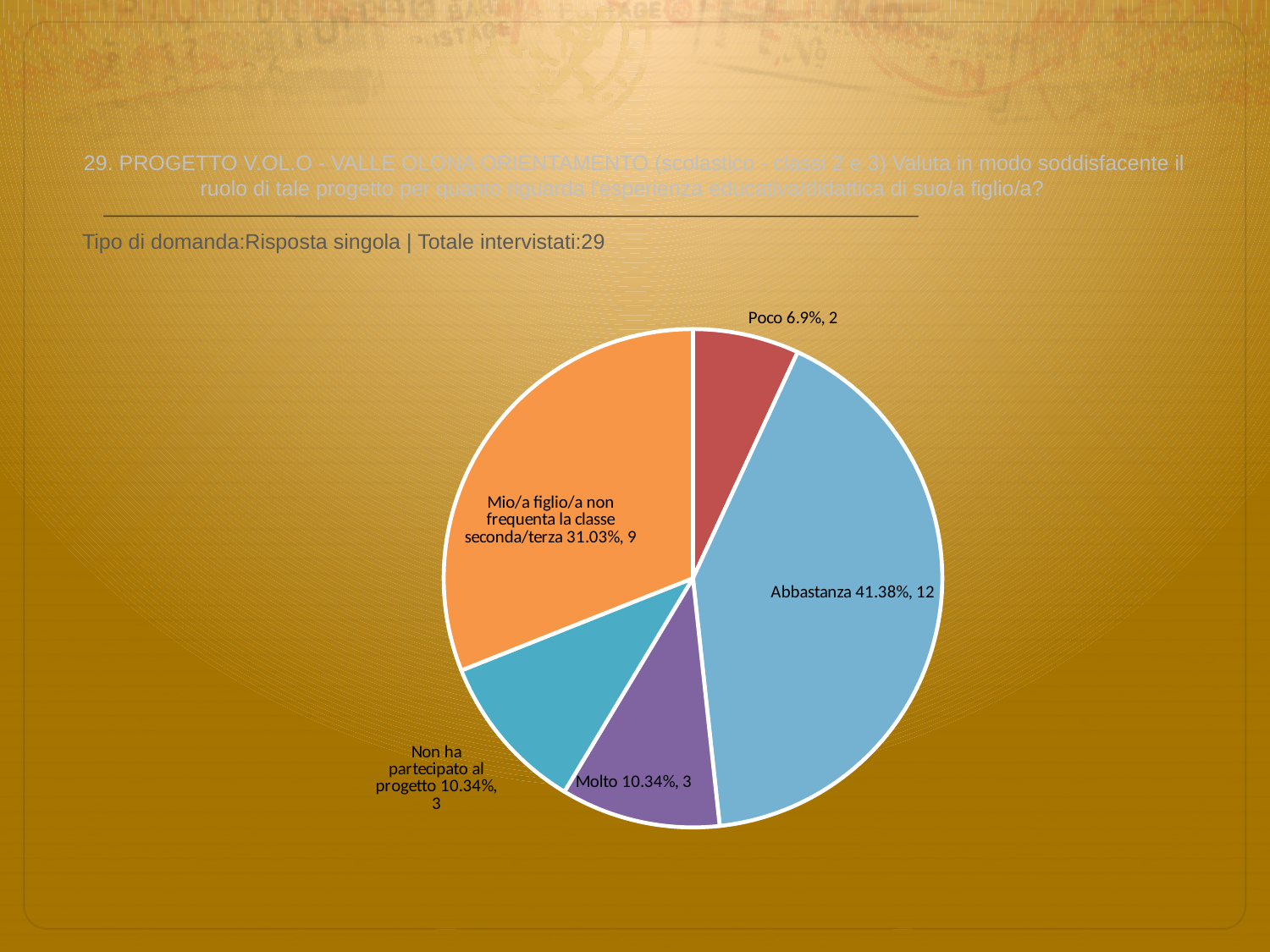
Which category has the largest slice of the pie? Abbastanza Which has more respondents, 'Molto' or 'Poco'? Molto How many respondents answered 'Molto'? 3 What is the total number of respondents (Totale intervistati) stated on the slide? 29 How many slices does the pie chart have? 5 What percentage share does the 'Abbastanza' slice have? 41.38% What type of chart is shown on the slide? pie chart What colour is the 'Abbastanza' slice? light blue How many respondents answered 'Poco'? 2 What percentage share does the 'Mio/a figlio/a non frequenta la classe seconda/terza' slice have? 31.03% Which category has the smallest slice of the pie? Poco What is the difference in respondent count between 'Abbastanza' and 'Mio/a figlio/a non frequenta la classe seconda/terza'? 3